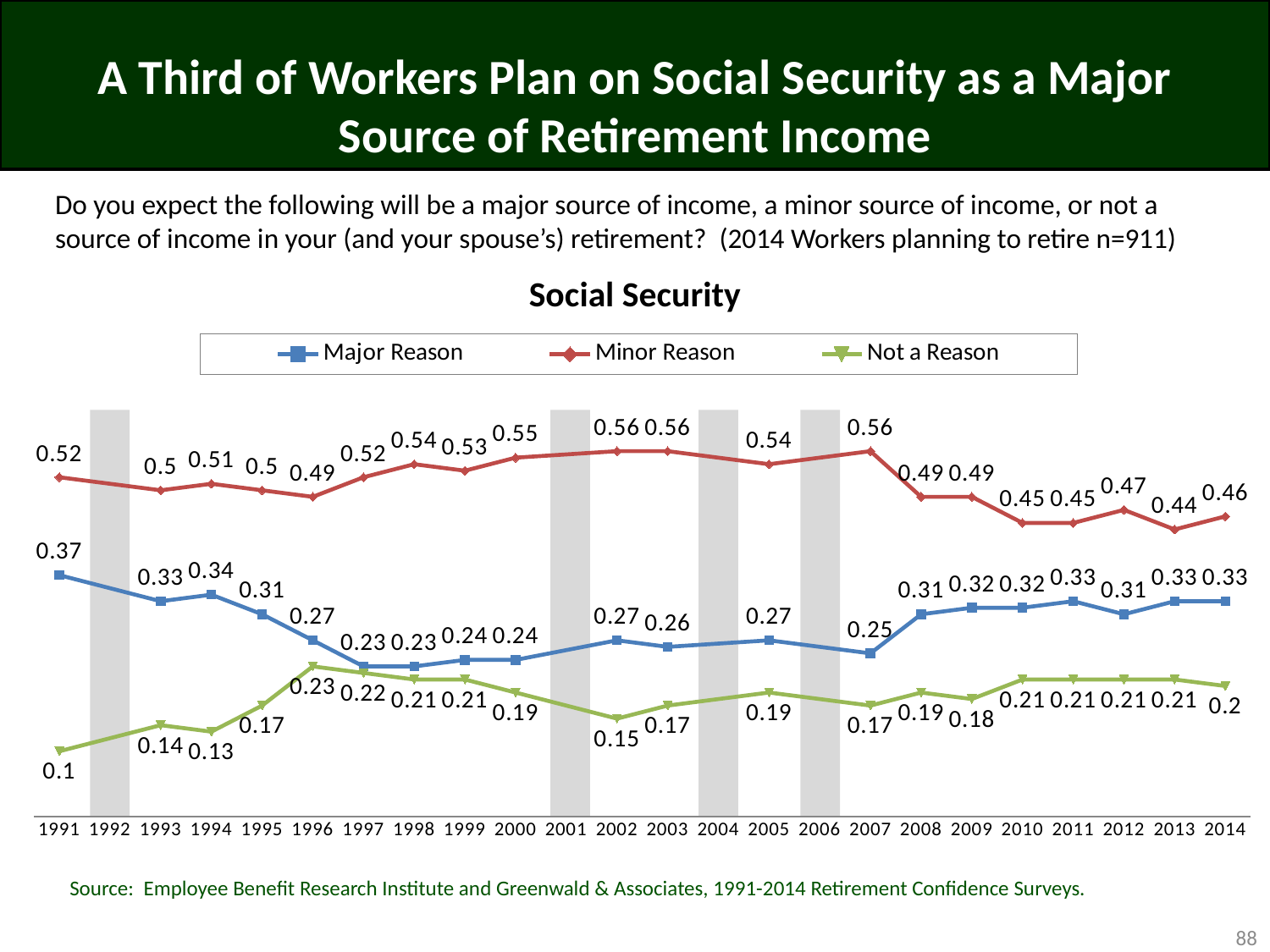
In which year is the Not a Reason value lowest? 1991 What is the Major Reason value for 2008? 0.31 What is the Minor Reason value for 2014? 0.46 In which year is the Minor Reason value lowest? 2013 In which year is the Major Reason value highest? 1991 What kind of chart is shown on the slide? Line chart What is the difference between the Minor Reason and Major Reason values in 2014? 0.13 How many series does the legend list? 3 What is the Not a Reason value for 2002? 0.15 Which is larger in 1996, the Major Reason value or the Not a Reason value? Major Reason What is the title of the chart? Social Security What is the Major Reason value for 1991? 0.37